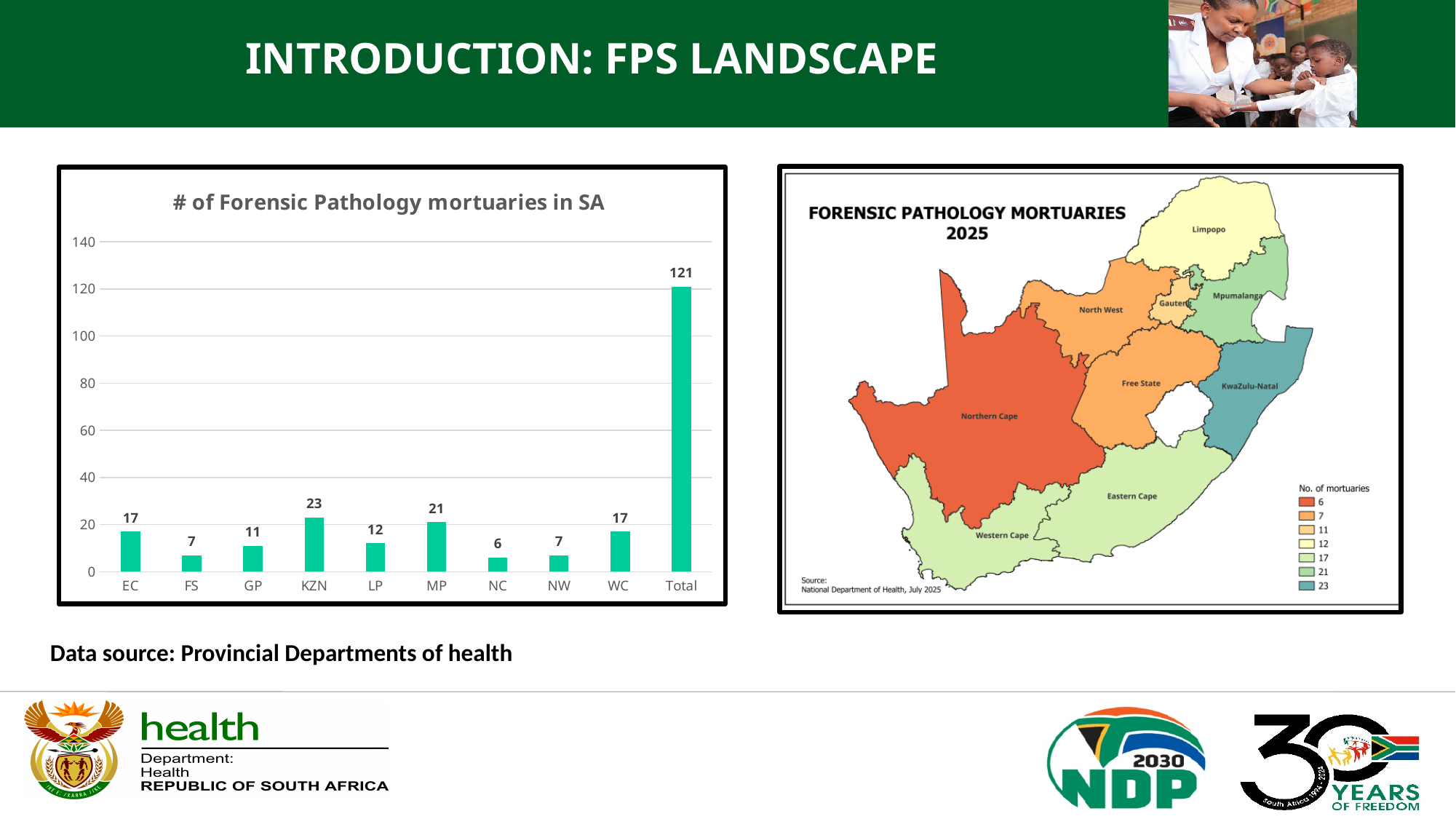
How many Forensic Pathology mortuaries does KZN have according to the bar chart? 23 Which province has the lowest number of Forensic Pathology mortuaries in the bar chart? NC What type of chart is used to show the number of Forensic Pathology mortuaries in SA? bar chart Which has more Forensic Pathology mortuaries, GP or LP? LP What is the difference between the values for KZN and NC in the bar chart? 17 Excluding the Total bar, which province has the highest number of Forensic Pathology mortuaries? KZN What is the value shown for MP in the bar chart? 21 Is the value for the Total bar greater or less than 100? greater What is the title of the bar chart? # of Forensic Pathology mortuaries in SA What is the Total value shown in the bar chart? 121 How many categories are shown on the x axis of the bar chart? 10 What is the value shown for FS in the bar chart? 7